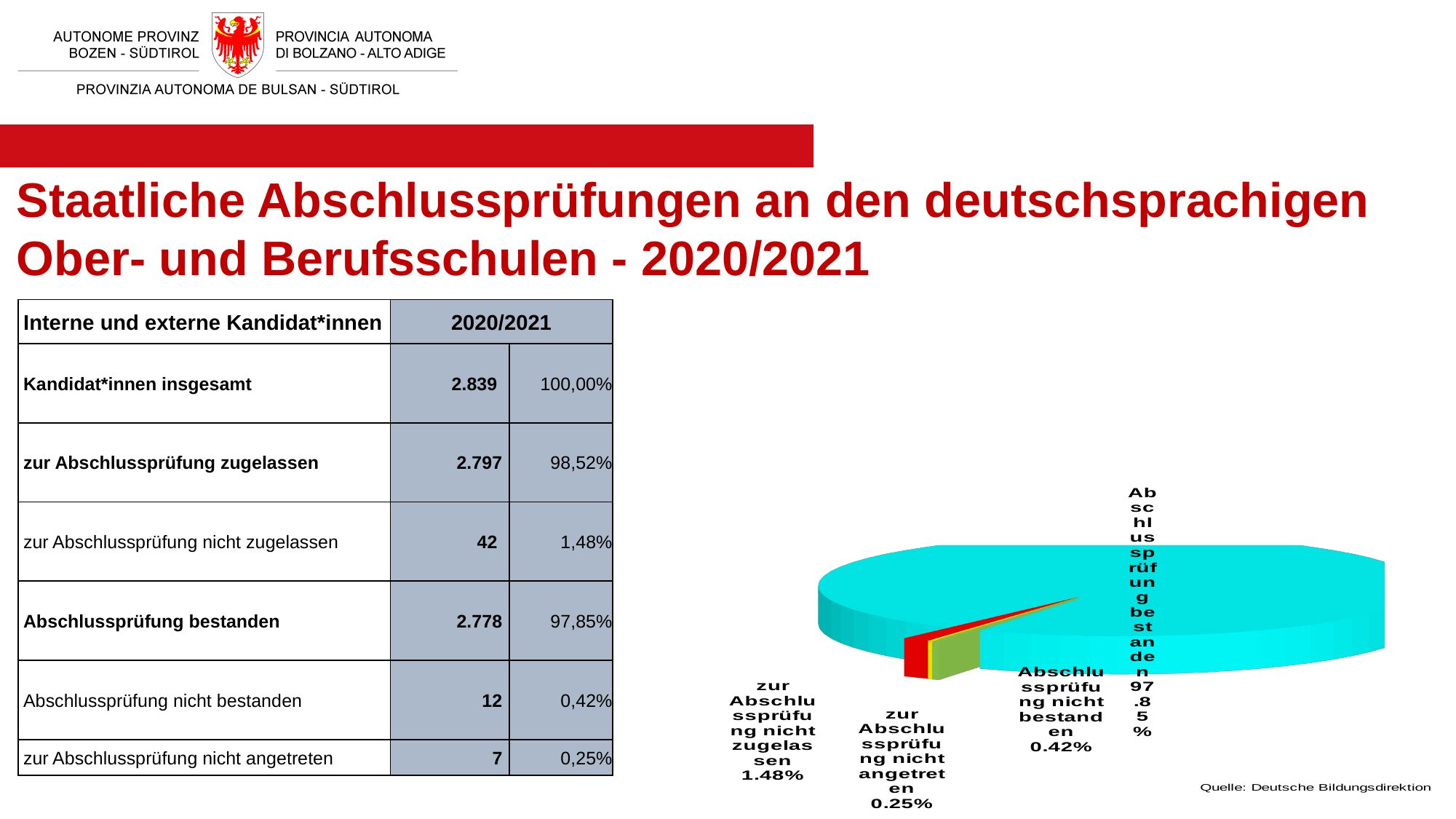
How many slices does the pie chart have? 4 In the pie chart, which is larger: "zur Abschlussprüfung nicht zugelassen" or "Abschlussprüfung nicht bestanden"? zur Abschlussprüfung nicht zugelassen What share of the pie is labelled "Abschlussprüfung bestanden"? 97.85% What share of the pie is labelled "zur Abschlussprüfung nicht angetreten"? 0.25% What kind of chart is shown on the slide? pie chart What share of the pie is labelled "Abschlussprüfung nicht bestanden"? 0.42% Which slice of the pie chart is the largest? Abschlussprüfung bestanden In the pie chart, what is the difference between the shares for "Abschlussprüfung nicht bestanden" and "zur Abschlussprüfung nicht angetreten"? 0.17% In the pie chart, what is the difference between the shares for "zur Abschlussprüfung nicht zugelassen" and "Abschlussprüfung nicht bestanden"? 1.06% What colour is the largest slice of the pie chart? cyan Which slice of the pie chart is the smallest? zur Abschlussprüfung nicht angetreten